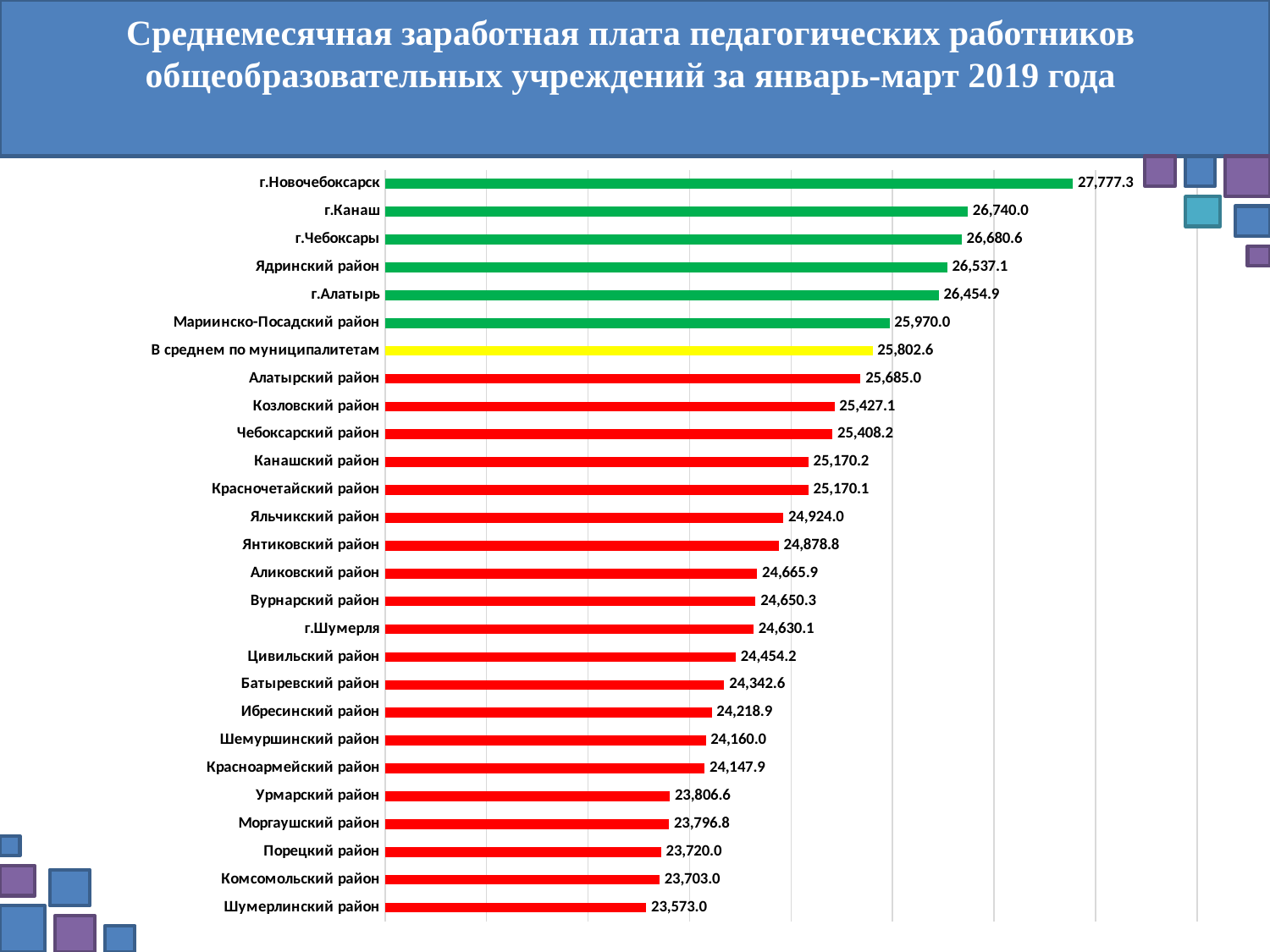
Which has a larger value, Ядринский район or Мариинско-Посадский район? Ядринский район What colour is the bar for В среднем по муниципалитетам? Yellow What type of chart is shown on the slide? Bar chart Which category has the highest value? г.Новочебоксарск What value is shown for В среднем по муниципалитетам? 25,802.6 Which category has the lowest value? Шумерлинский район How many categories are plotted on the chart? 27 What is the average monthly salary shown for г.Новочебоксарск? 27,777.3 What is the value for Шумерлинский район? 23,573.0 What is the value for Красночетайский район? 25,170.1 What is the difference between the values for г.Канаш and г.Чебоксары? 59.4 What is the difference between the values for г.Новочебоксарск and Шумерлинский район? 4,204.3